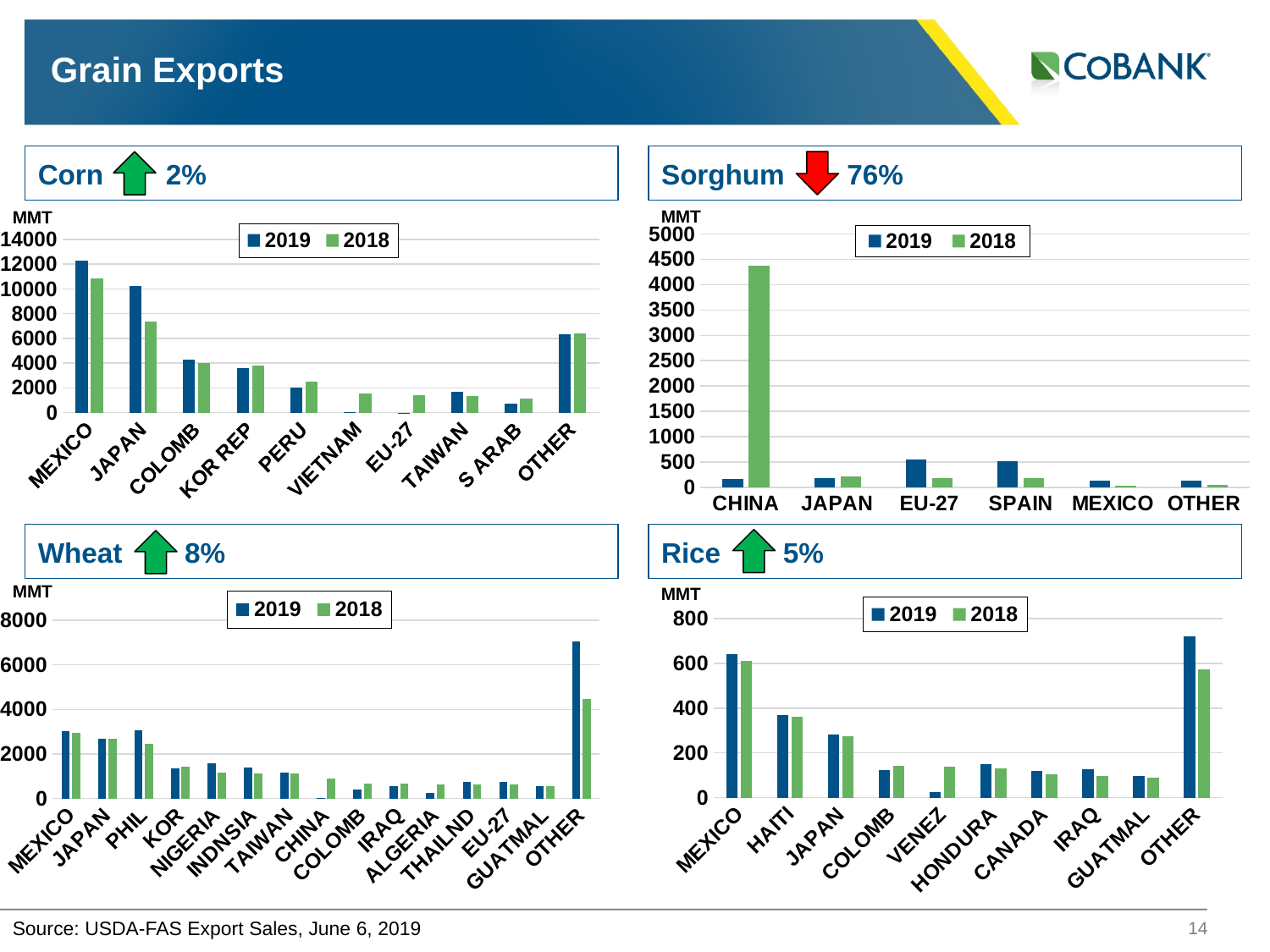
In the Sorghum chart, is the 2018 value for CHINA greater or less than 4000? greater What percentage change is shown in the title box of the Sorghum chart? 76% In the Corn chart, is the 2019 value for MEXICO greater or less than 10000? greater In the Corn chart, which is larger for VIETNAM, the 2019 value or the 2018 value? 2018 In the Corn chart, which category has the highest 2019 value? MEXICO How many categories are shown on the x axis of the Wheat chart? 15 What kind of chart is the Corn chart? bar chart In the Sorghum chart, which is larger for CHINA, the 2019 value or the 2018 value? 2018 How many series does the legend of the Sorghum chart list? 2 In the Wheat chart, which category has the highest 2019 value? OTHER How many categories are shown on the x axis of the Sorghum chart? 6 In the Rice chart, which category has the lowest 2019 value? VENEZ